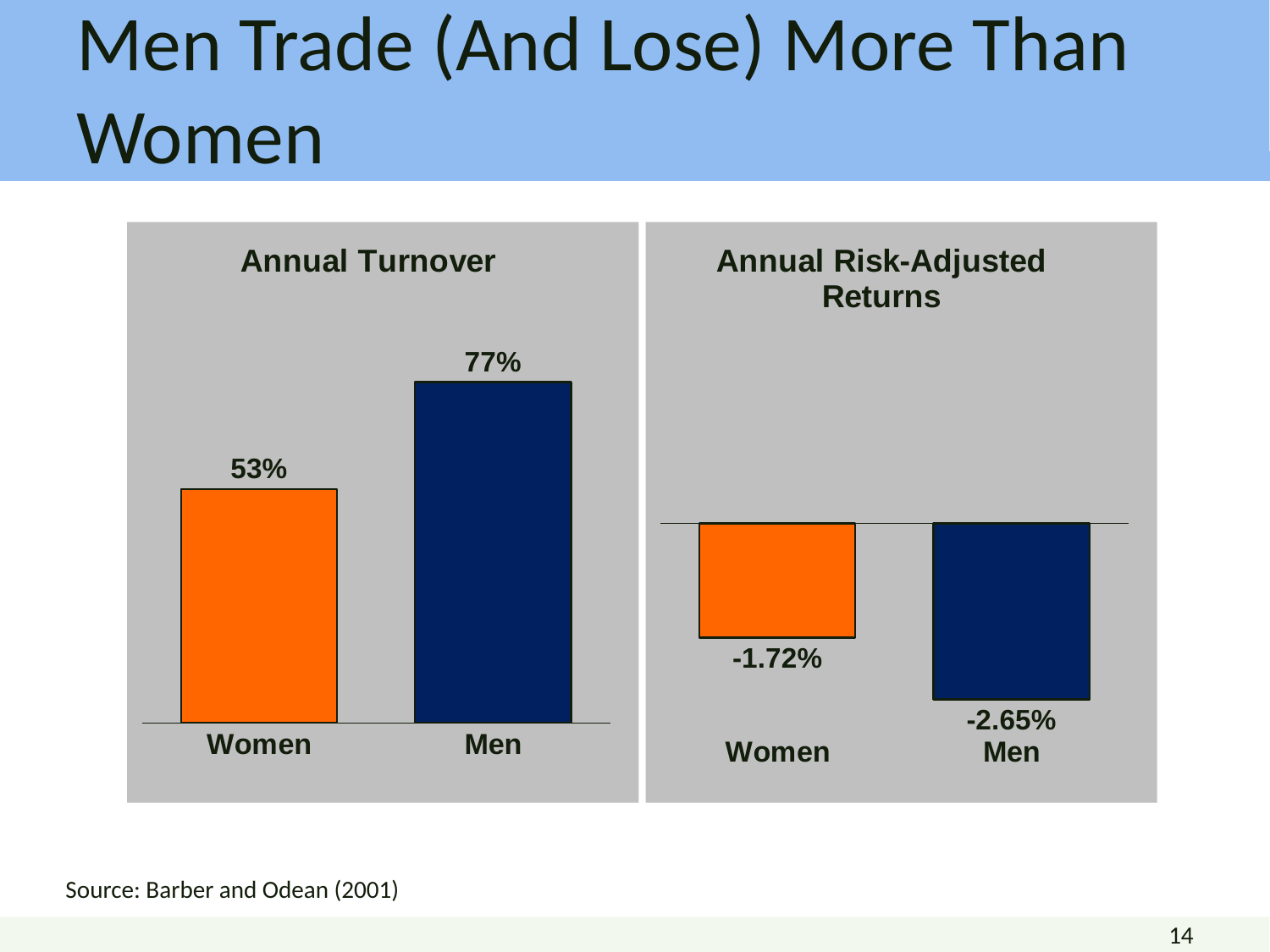
What kind of chart is the Annual Turnover chart? Bar chart In the Annual Turnover chart, what is the value for Women? 53% In the Annual Risk-Adjusted Returns chart, what is the value for Men? -2.65% In the Annual Turnover chart, what is the difference between the values for Men and Women? 24% In the Annual Turnover chart, what is the value for Men? 77% In the Annual Risk-Adjusted Returns chart, what is the value for Women? -1.72% In the Annual Risk-Adjusted Returns chart, which category has the lowest value? Men In the Annual Turnover chart, which category has the highest value? Men How many categories does the Annual Turnover chart show? 2 In the Annual Risk-Adjusted Returns chart, which is larger, the value for Women or the value for Men? Women In the Annual Risk-Adjusted Returns chart, what colour is the bar for Women? Orange In the Annual Risk-Adjusted Returns chart, what is the difference between the values for Women and Men? 0.93%